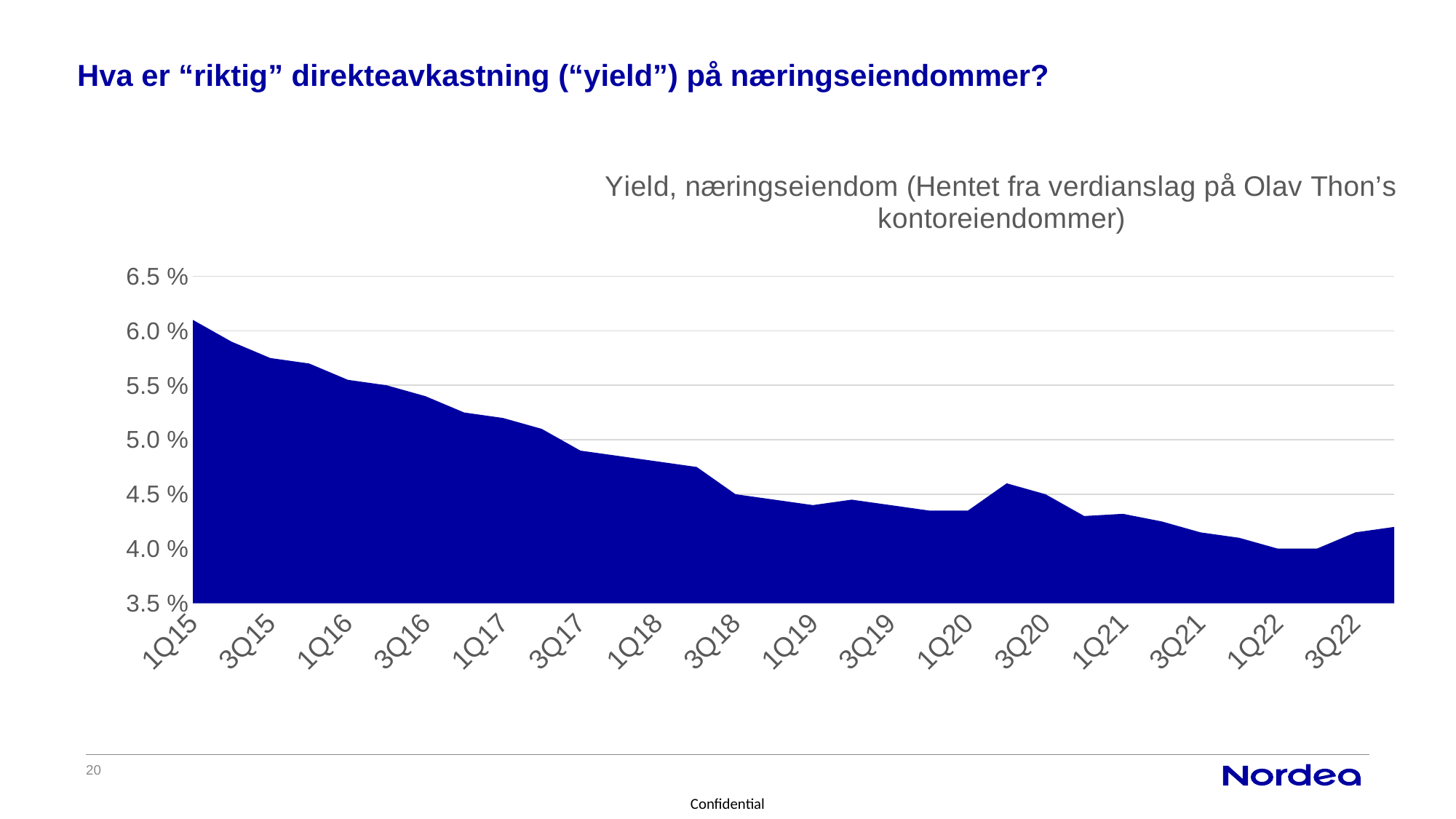
What is the title of the chart? Yield, næringseiendom (Hentet fra verdianslag på Olav Thon's kontoreiendommer) What kind of chart is shown on the slide? Area chart Which is larger, the yield in 1Q16 or in 1Q19? 1Q16 Which quarter has the highest yield? 1Q15 Is the yield for 1Q19 greater or less than 5.0 %? less Is the yield for 3Q22 greater or less than 4.5 %? less Does the yield generally rise or fall from 1Q15 to 3Q22? Fall Is the yield for 1Q15 greater or less than 5.5 %? greater How many quarter labels are shown on the x axis? 16 Which is larger, the yield in 1Q15 or in 3Q22? 1Q15